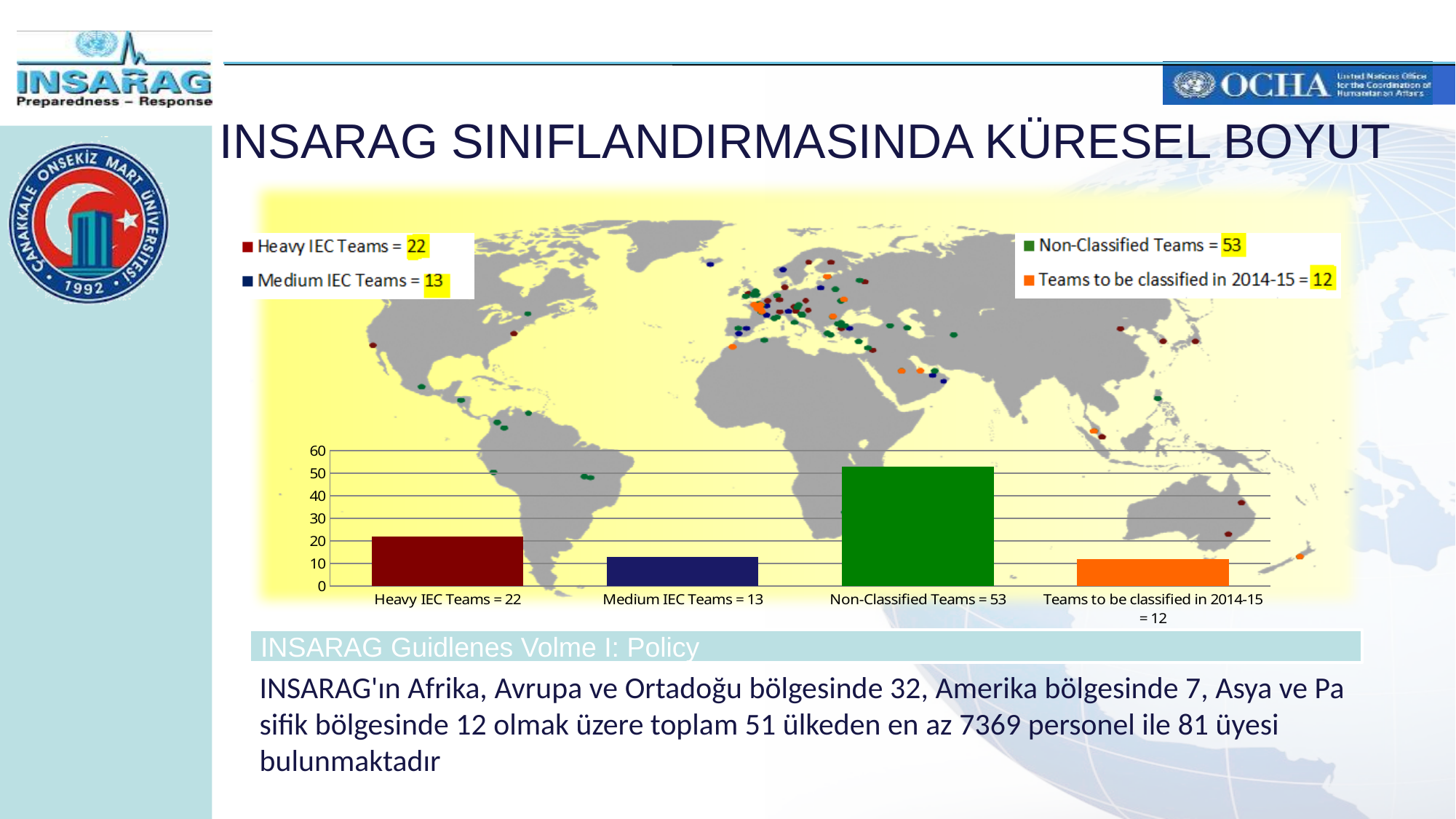
Which is larger, Heavy IEC Teams or Medium IEC Teams? Heavy IEC Teams What is the difference between Non-Classified Teams and Heavy IEC Teams? 31 What is the value for Medium IEC Teams? 13 What is the value for Non-Classified Teams? 53 Which category has the lowest value? Teams to be classified in 2014-15 What is the value for Heavy IEC Teams? 22 What is the value for Teams to be classified in 2014-15? 12 What kind of chart is shown on the slide? bar chart What colour is the bar for Non-Classified Teams? green Which category has the highest value? Non-Classified Teams Is the value for Non-Classified Teams greater or less than 50? greater How many categories does the bar chart show? 4